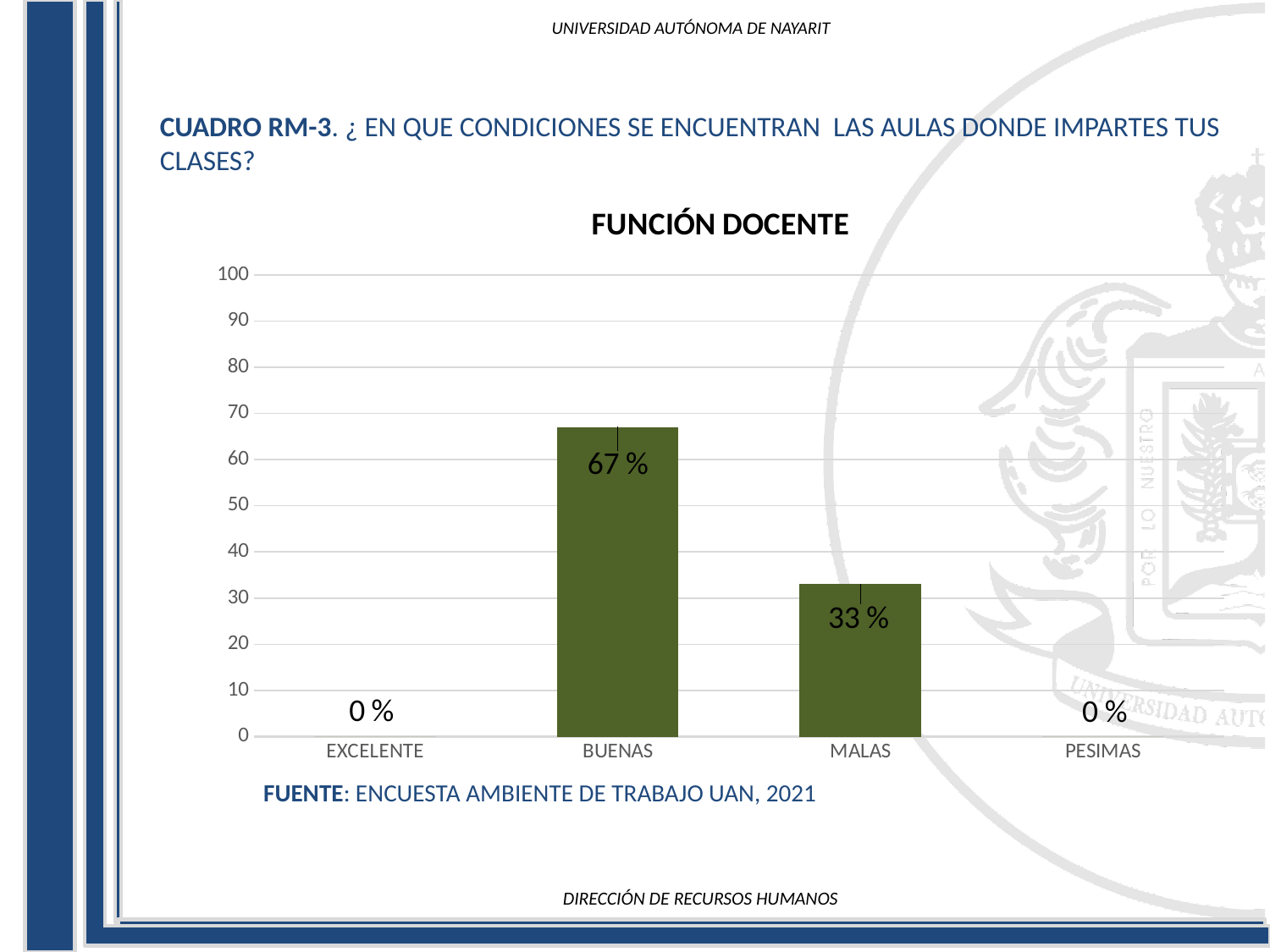
Is the value for BUENAS greater or less than 60? greater What kind of chart is shown on the slide? bar chart What is the difference between the values for BUENAS and MALAS? 34 % What is the title of the chart? FUNCIÓN DOCENTE Which is larger, the value for BUENAS or the value for MALAS? BUENAS What is the value for EXCELENTE? 0 % Is the value for MALAS greater or less than 40? less How many categories are shown on the x axis? 4 What is the value for BUENAS? 67 % What is the value for PESIMAS? 0 % What is the value for MALAS? 33 % Which category has the highest value? BUENAS